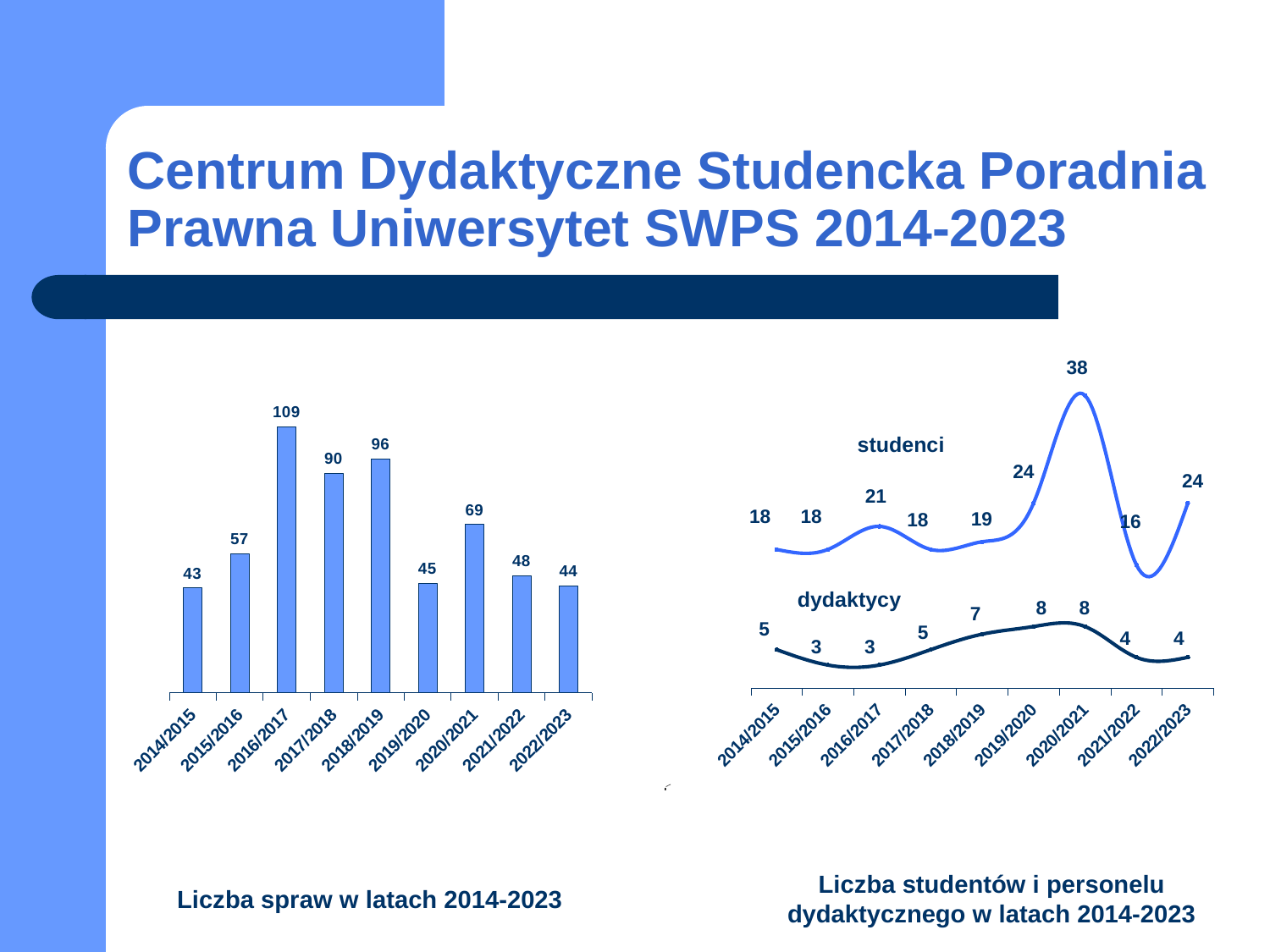
In the right chart (Liczba studentów i personelu dydaktycznego), in which year is the studenci value lowest? 2021/2022 What kind of chart is the left chart (Liczba spraw w latach 2014-2023)? bar chart In the right chart (Liczba studentów i personelu dydaktycznego), what is the value for studenci in 2020/2021? 38 In the left chart (Liczba spraw w latach 2014-2023), which is larger, the value for 2015/2016 or the value for 2021/2022? 2015/2016 In the left chart (Liczba spraw w latach 2014-2023), which year has the lowest number of cases? 2014/2015 In the left chart (Liczba spraw w latach 2014-2023), what is the difference between the values for 2018/2019 and 2019/2020? 51 In the left chart (Liczba spraw w latach 2014-2023), how many years are shown on the x axis? 9 In the right chart (Liczba studentów i personelu dydaktycznego), what is the difference between studenci and dydaktycy in 2022/2023? 20 In the right chart (Liczba studentów i personelu dydaktycznego), what is the value for dydaktycy in 2017/2018? 5 What kind of chart is the right chart (Liczba studentów i personelu dydaktycznego)? line chart In the left chart (Liczba spraw w latach 2014-2023), what is the value for 2016/2017? 109 How many series are plotted in the right chart (Liczba studentów i personelu dydaktycznego)? 2